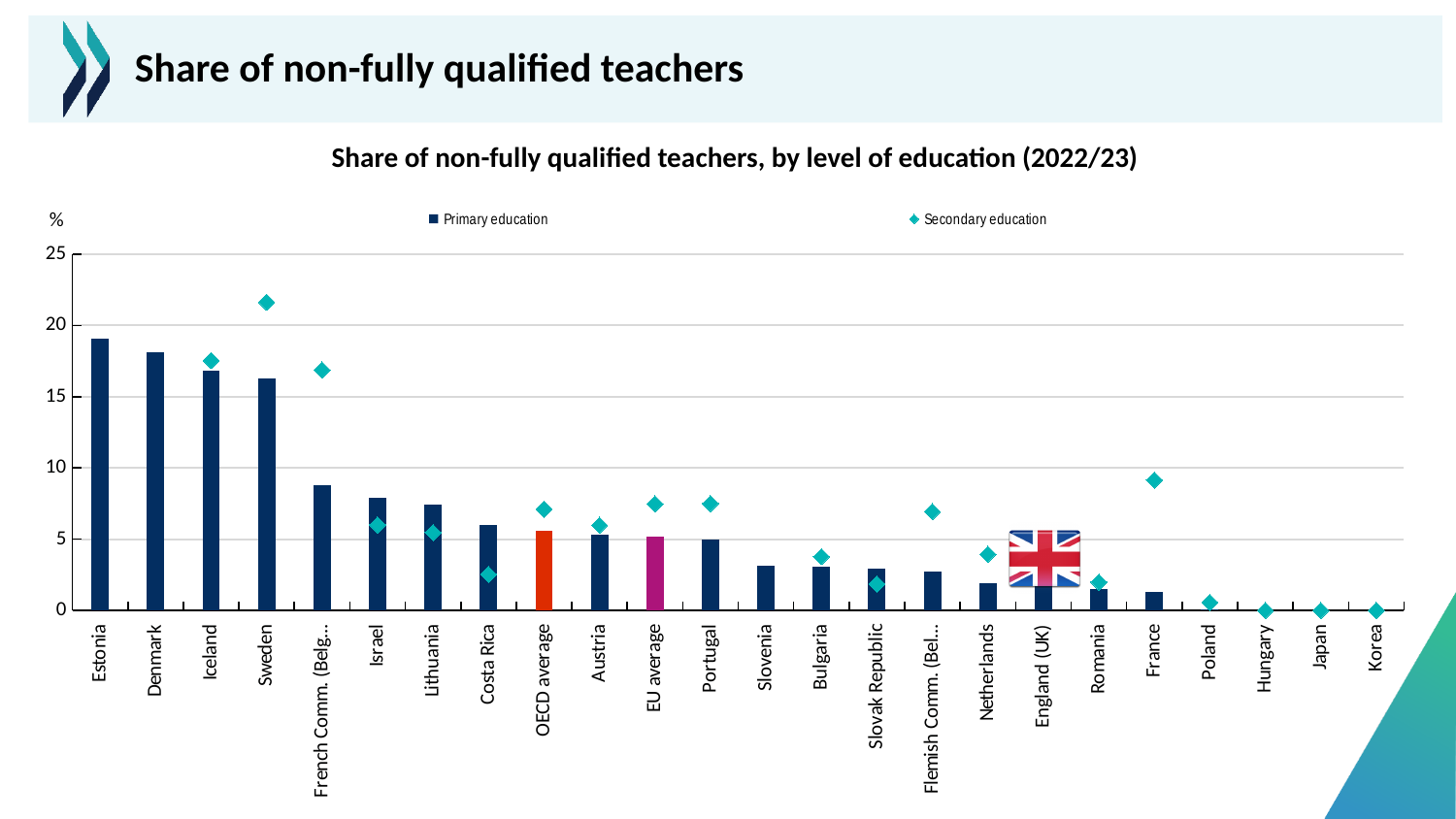
Which category has the highest Primary education bar? Estonia Which is larger for Costa Rica, the Primary education value or the Secondary education value? Primary education Which series is shown as diamond markers rather than bars? Secondary education How many countries or averages are shown along the x axis? 24 Which category has the highest Secondary education marker? Sweden How many series does the legend list? 2 Is the Secondary education value for France greater or less than 5? greater Do the Primary education bars generally rise or fall from left to right along the x axis? fall What is the title of the chart? Share of non-fully qualified teachers, by level of education (2022/23) Is the Secondary education value for Sweden greater or less than 20? greater Is the Primary education value for Estonia greater or less than 15? greater